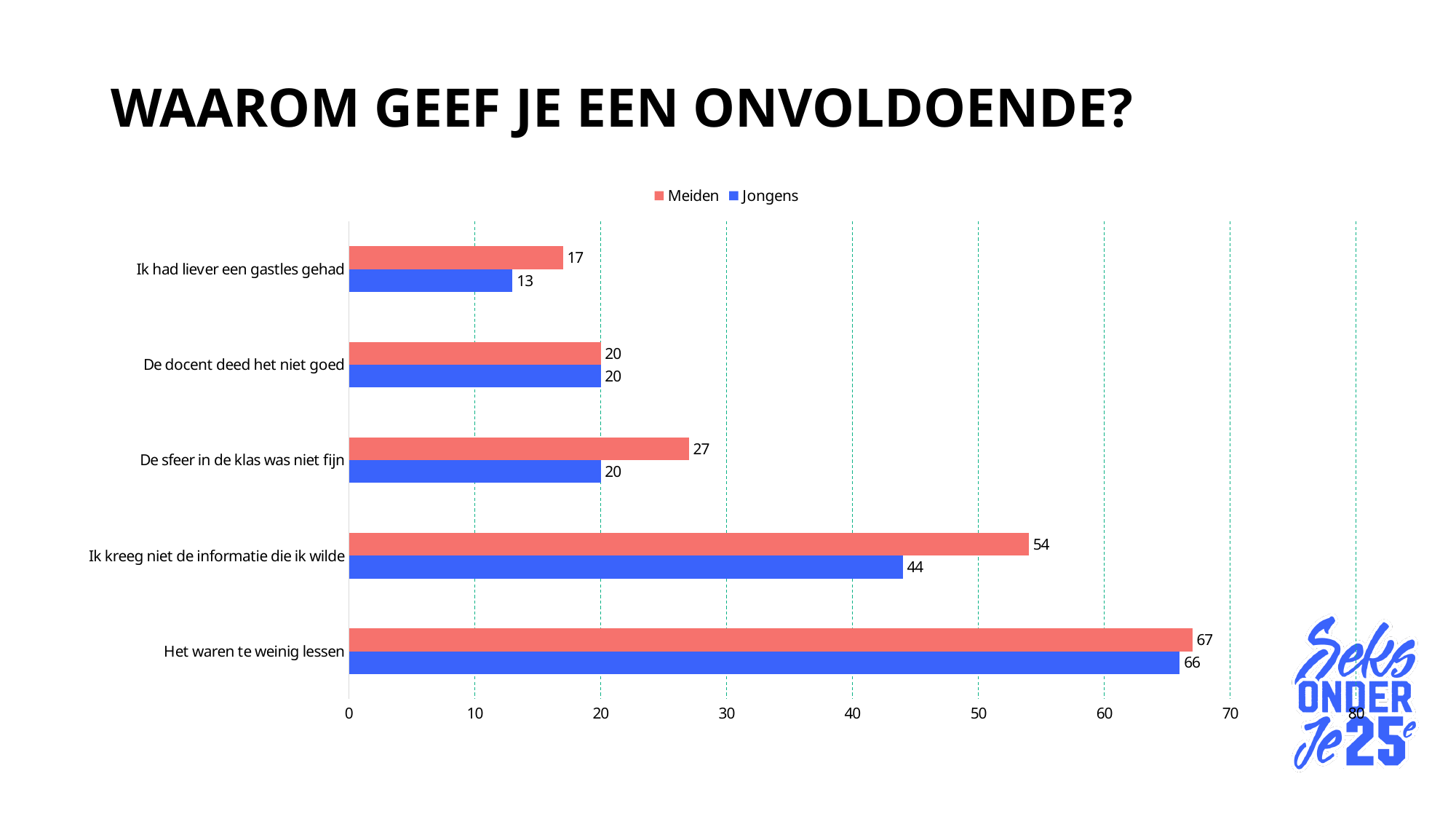
What kind of chart is shown on the slide? bar chart What is the value for Jongens for "Ik had liever een gastles gehad"? 13 Which category has the highest value for Meiden? Het waren te weinig lessen How many categories are shown on the chart? 5 Is the value for Meiden for "Ik kreeg niet de informatie die ik wilde" greater or less than 50? greater What is the value for Jongens for "Ik kreeg niet de informatie die ik wilde"? 44 What is the value for Meiden for "Het waren te weinig lessen"? 67 Which category has the lowest value for Jongens? Ik had liever een gastles gehad What is the difference between Meiden and Jongens for "Ik kreeg niet de informatie die ik wilde"? 10 Which colour represents Jongens in the chart? blue Which is larger for "De sfeer in de klas was niet fijn": Meiden or Jongens? Meiden How many series does the legend list? 2